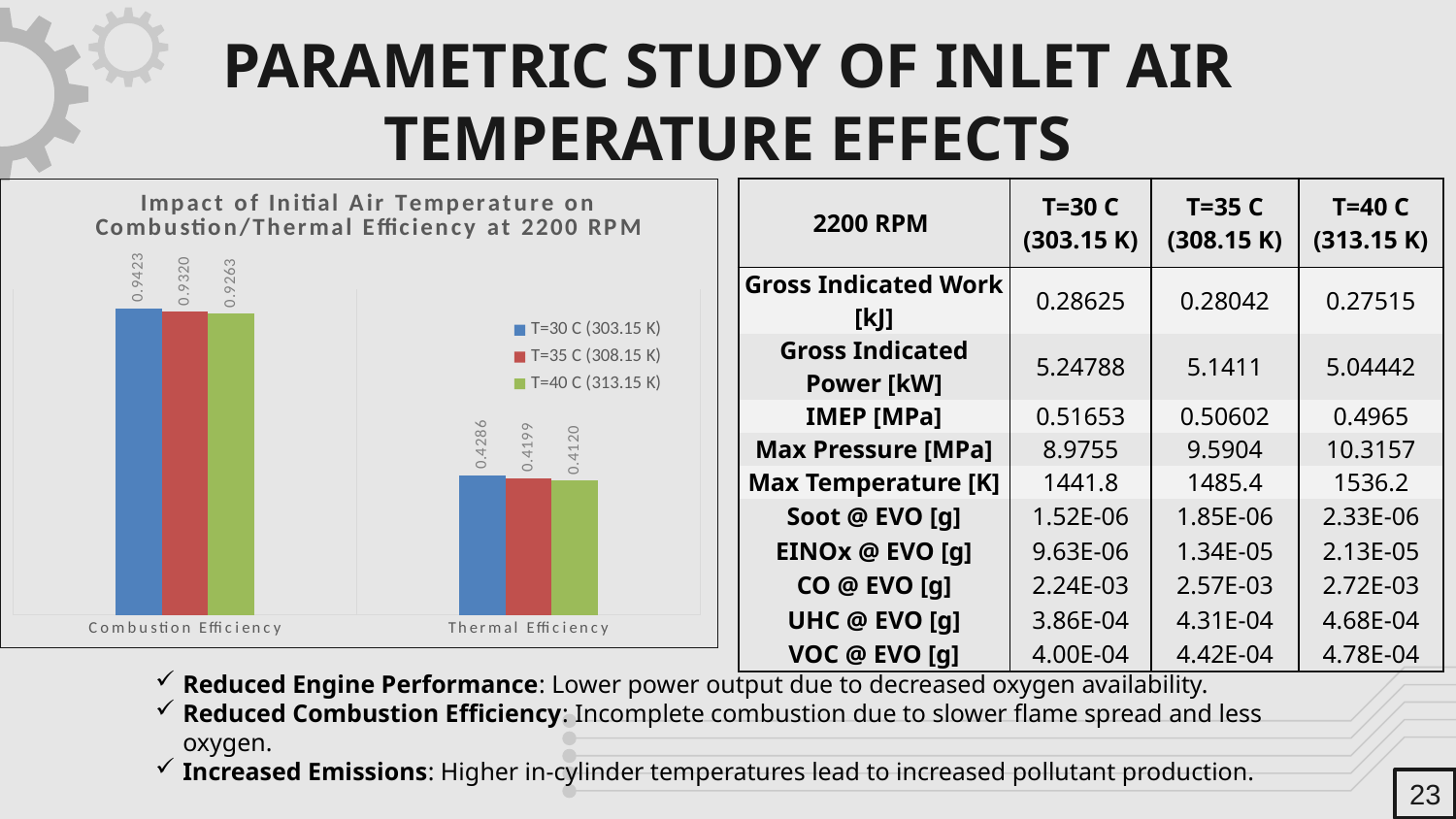
What type of chart is shown on the slide? Bar chart What is the title of the chart? Impact of Initial Air Temperature on Combustion/Thermal Efficiency at 2200 RPM How many series does the chart legend list? 3 What is the combustion efficiency for T=35 C (308.15 K)? 0.9320 Which inlet air temperature gives the lowest thermal efficiency? T=40 C (313.15 K) What is the difference between the thermal efficiency at T=30 C and at T=35 C? 0.0087 Which is larger: the combustion efficiency at T=35 C or the combustion efficiency at T=40 C? Combustion efficiency at T=35 C What is the combustion efficiency for T=30 C (303.15 K)? 0.9423 What is the difference between the combustion efficiency at T=30 C and at T=40 C? 0.0160 What is the thermal efficiency for T=40 C (313.15 K)? 0.4120 What is the thermal efficiency for T=35 C (308.15 K)? 0.4199 Which inlet air temperature gives the highest combustion efficiency? T=30 C (303.15 K)